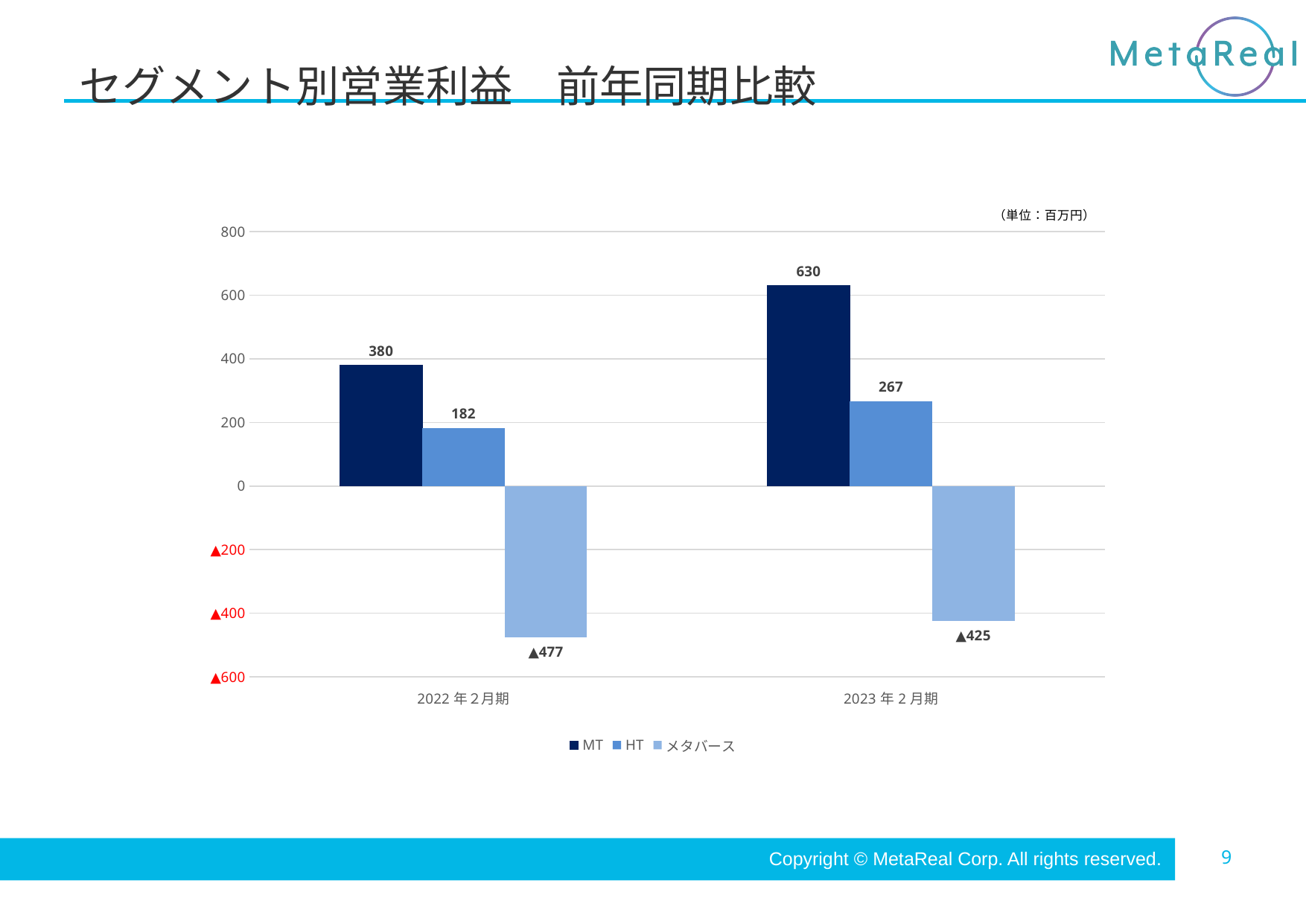
How many series does the legend list? 3 What unit is stated for the values in the chart? 百万円 Which is larger, the HT value in 2022年2月期 or in 2023年2月期? 2023年2月期 What is the value for メタバース in 2023年2月期? ▲425 What is the value for HT in 2023年2月期? 267 Which segment has the highest value in 2023年2月期? MT Which segment has the lowest value in 2022年2月期? メタバース What is the value for メタバース in 2022年2月期? ▲477 What is the difference between the MT values for 2023年2月期 and 2022年2月期? 250 What is the value for MT in 2022年2月期? 380 Does the MT value rise or fall from 2022年2月期 to 2023年2月期? Rise What kind of chart is shown on the slide? Bar chart